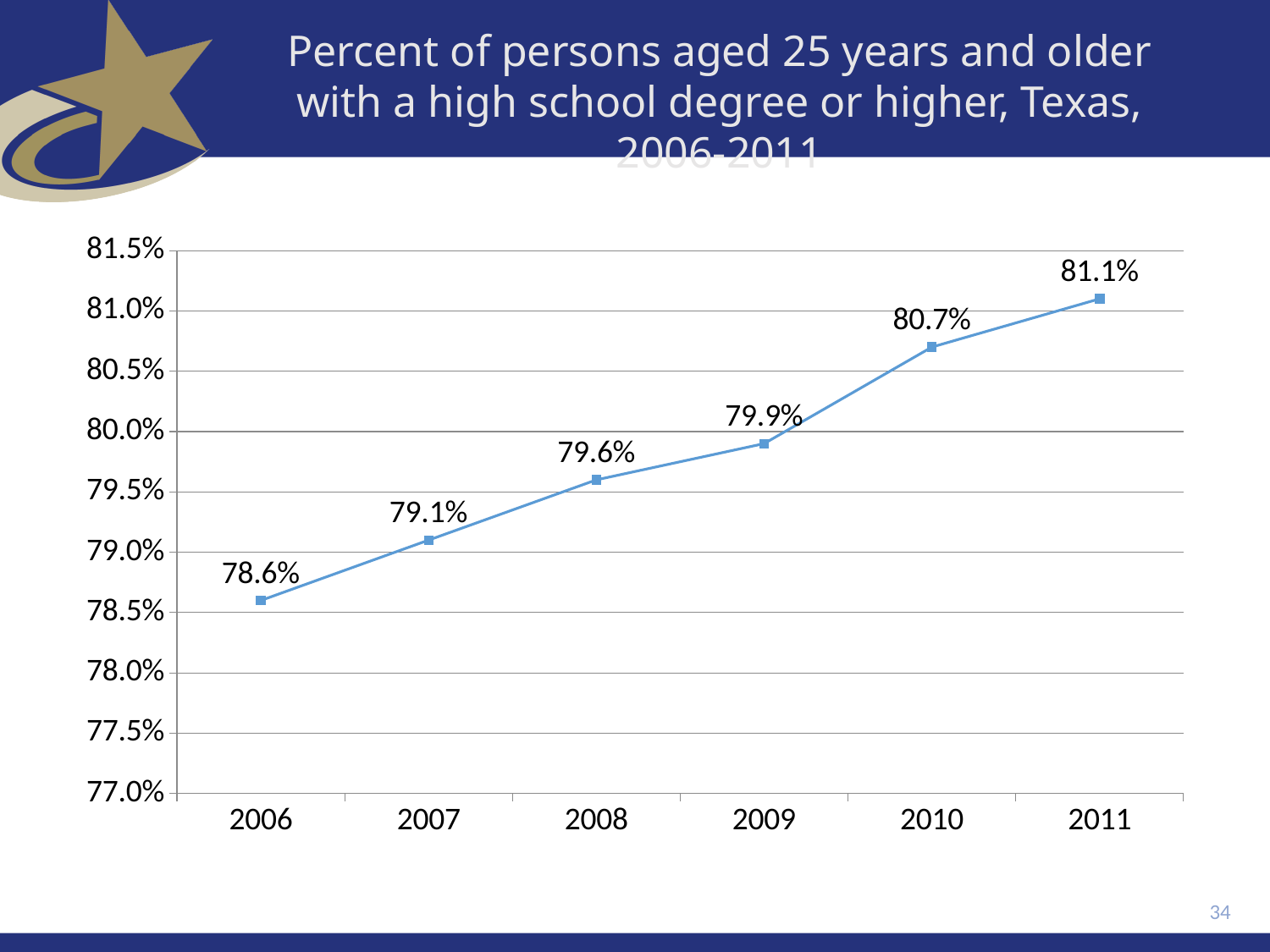
What is the value for 2011? 81.1% What kind of chart is shown? line chart Is the value for 2010 greater or less than 80.5%? greater What is the difference between the values for 2011 and 2006? 2.5% What is the difference between the values for 2010 and 2009? 0.8% Which is larger, the value for 2008 or the value for 2007? 2008 Which year has the highest value? 2011 Which year has the lowest value? 2006 What is the value for 2009? 79.9% Do the values rise or fall from 2006 to 2011? rise What is the value for 2006? 78.6% How many years are plotted on the chart? 6